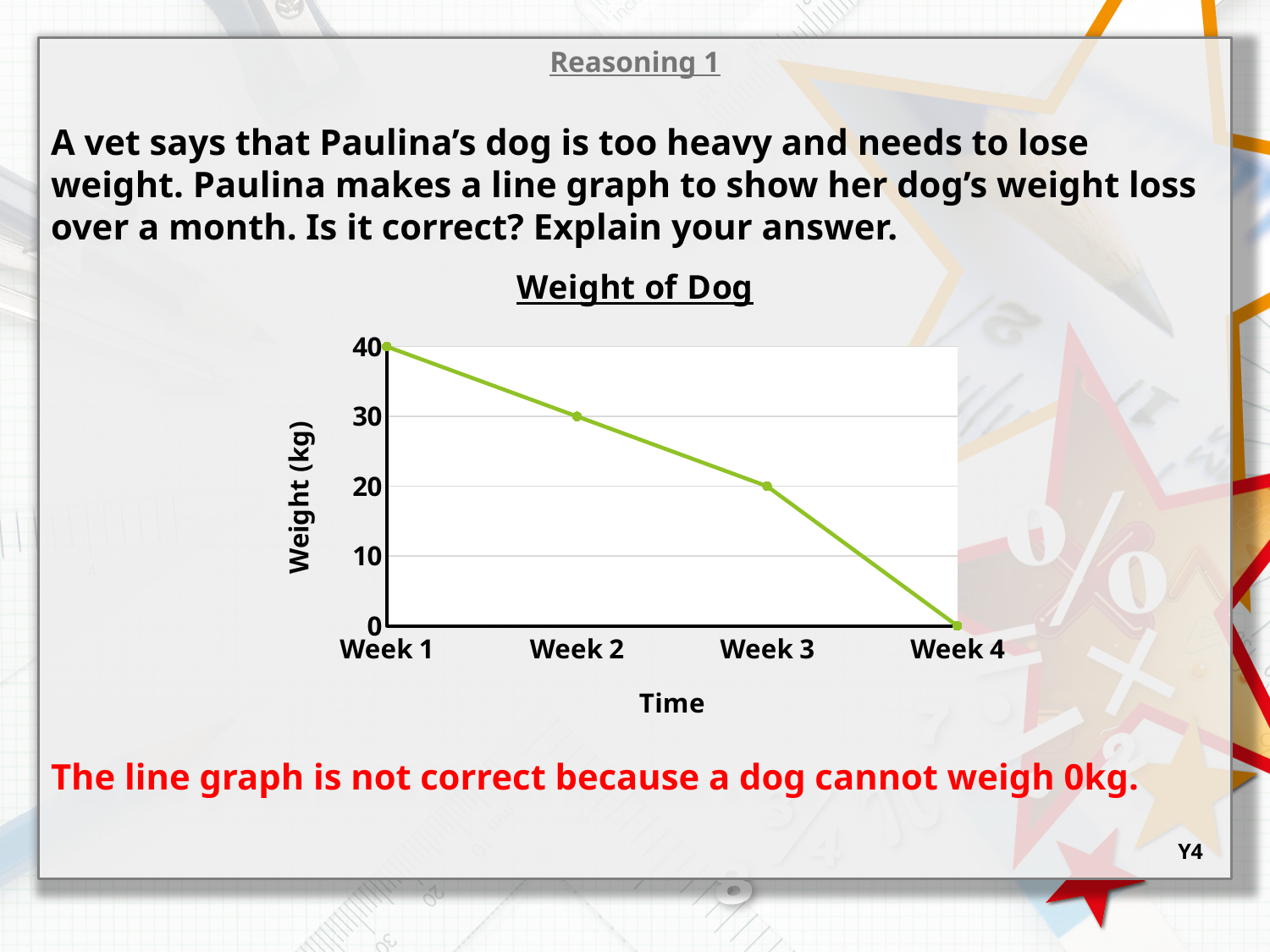
What is the title of the chart? Weight of Dog What is the weight of the dog in Week 3? 20 kg What kind of chart is shown on the slide? line chart In which week is the dog's weight highest? Week 1 How many weeks are plotted on the x axis? 4 Which is larger, the weight in Week 2 or the weight in Week 4? Week 2 What is the weight of the dog in Week 2? 30 kg Does the dog's weight rise or fall from Week 1 to Week 4? fall In which week is the dog's weight lowest? Week 4 What is the weight of the dog in Week 1? 40 kg What is the difference in weight between Week 1 and Week 3? 20 kg What is the weight of the dog in Week 4? 0 kg